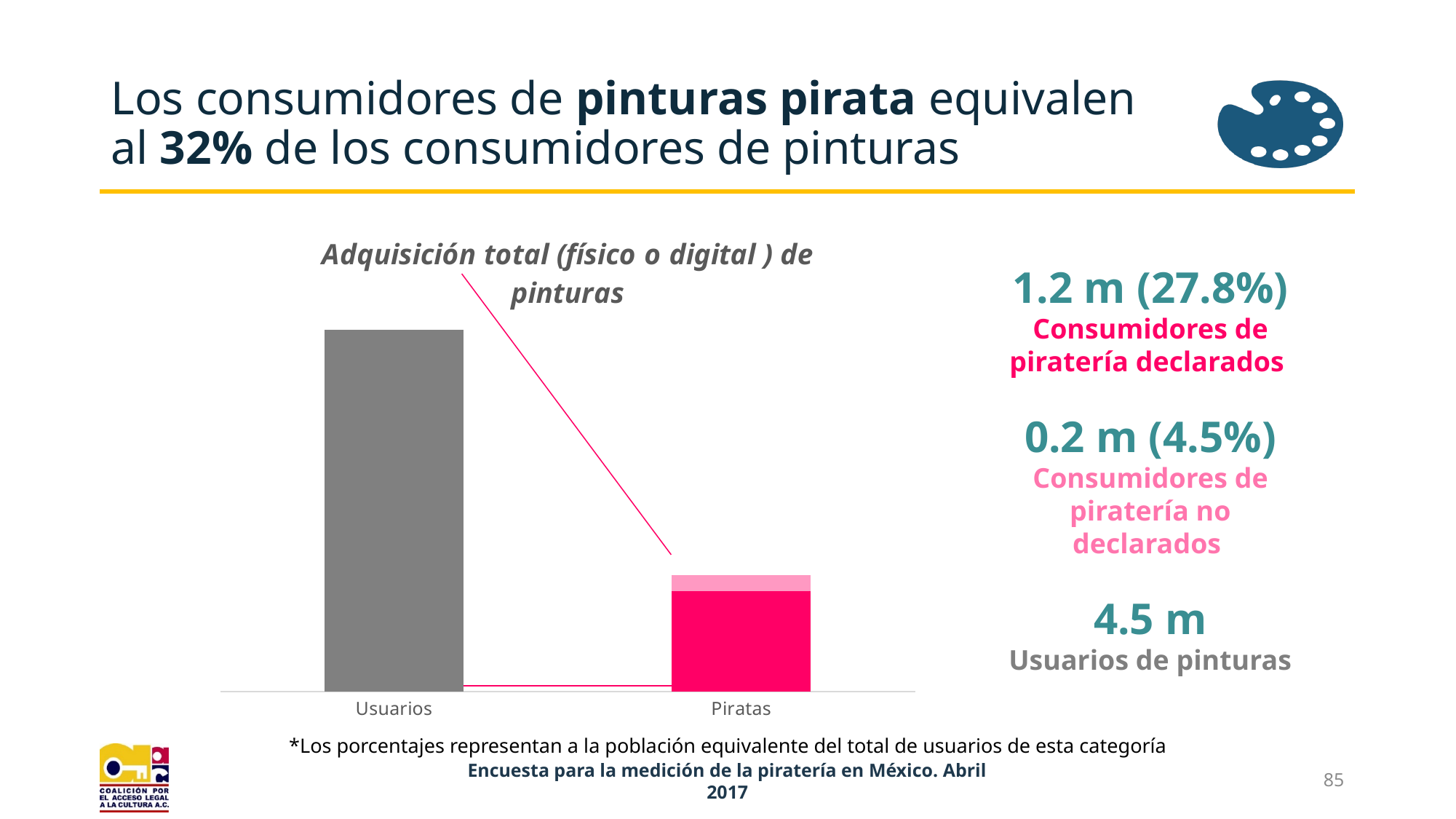
According to the slide title, what percentage of paint consumers do pirate paint consumers represent? 32% According to the slide, what is the value for Consumidores de piratería declarados? 1.2 m (27.8%) How many categories are shown on the x axis of the chart? 2 Which category has the taller bar, Usuarios or Piratas? Usuarios Which category has the highest bar in the chart? Usuarios What colour is the Usuarios bar? grey What kind of chart is shown on the slide? bar chart How many segments make up the Piratas bar? 2 According to the slide, what is the value for Consumidores de piratería no declarados? 0.2 m (4.5%) What is the title of the chart? Adquisición total (físico o digital ) de pinturas Which category has the lowest bar in the chart? Piratas According to the slide, how many Usuarios de pinturas are there? 4.5 m